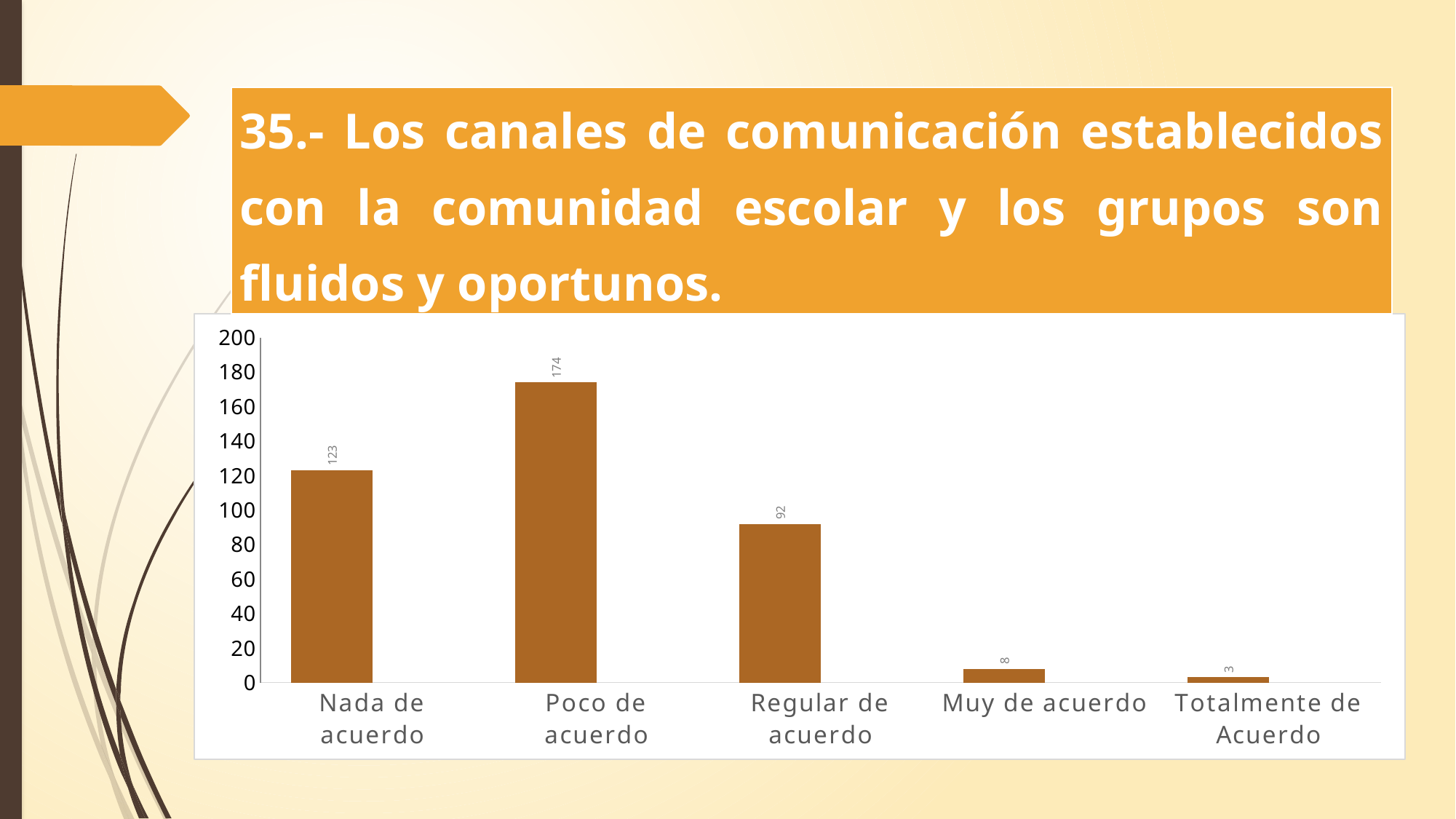
Which category has the highest value? Poco de acuerdo Is the value for "Regular de acuerdo" greater or less than 100? less Which category has the lowest value? Totalmente de Acuerdo What kind of chart is shown on the slide? Bar chart What is the value for "Totalmente de Acuerdo"? 3 What is the value for "Nada de acuerdo"? 123 How many categories are shown on the x axis? 5 What is the value for "Muy de acuerdo"? 8 What is the value for "Poco de acuerdo"? 174 What is the value for "Regular de acuerdo"? 92 Which is larger, the value for "Nada de acuerdo" or the value for "Regular de acuerdo"? Nada de acuerdo What is the difference between the values for "Poco de acuerdo" and "Nada de acuerdo"? 51